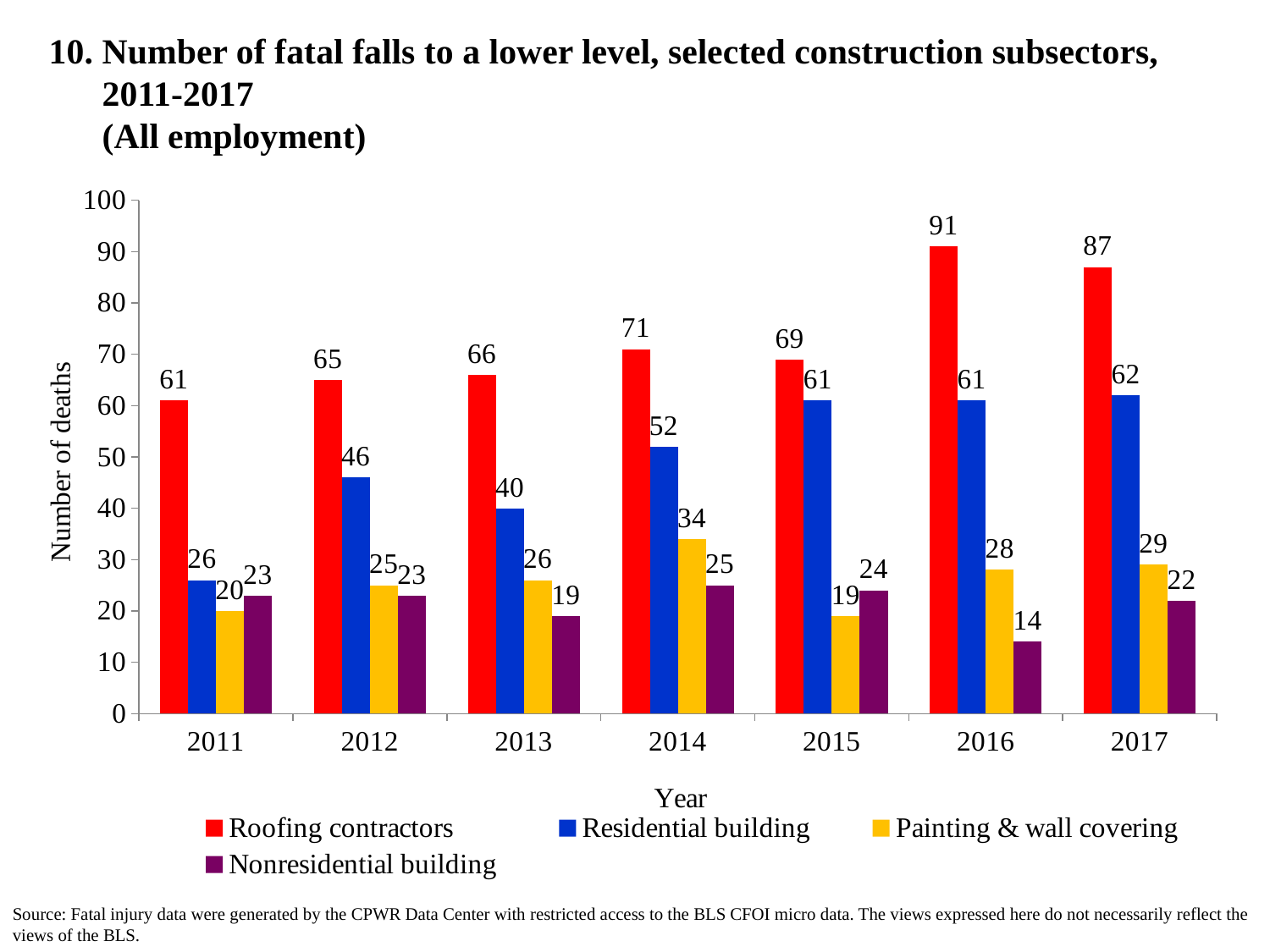
What was the number of deaths for residential building in 2014? 52 How many fatal falls to a lower level were there among roofing contractors in 2016? 91 In which year did nonresidential building have the lowest number of deaths? 2016 In which year did roofing contractors have the highest number of fatal falls? 2016 What was the number of deaths for painting & wall covering in 2015? 19 Did the number of deaths for residential building rise or fall from 2011 to 2017? Rise What kind of chart is shown on the slide? Bar chart How many years are shown on the x axis? 7 What colour represents roofing contractors in the chart? Red Which had more deaths in 2013: painting & wall covering or nonresidential building? Painting & wall covering How many series does the legend list? 4 What is the difference between roofing contractors and residential building deaths in 2017? 25